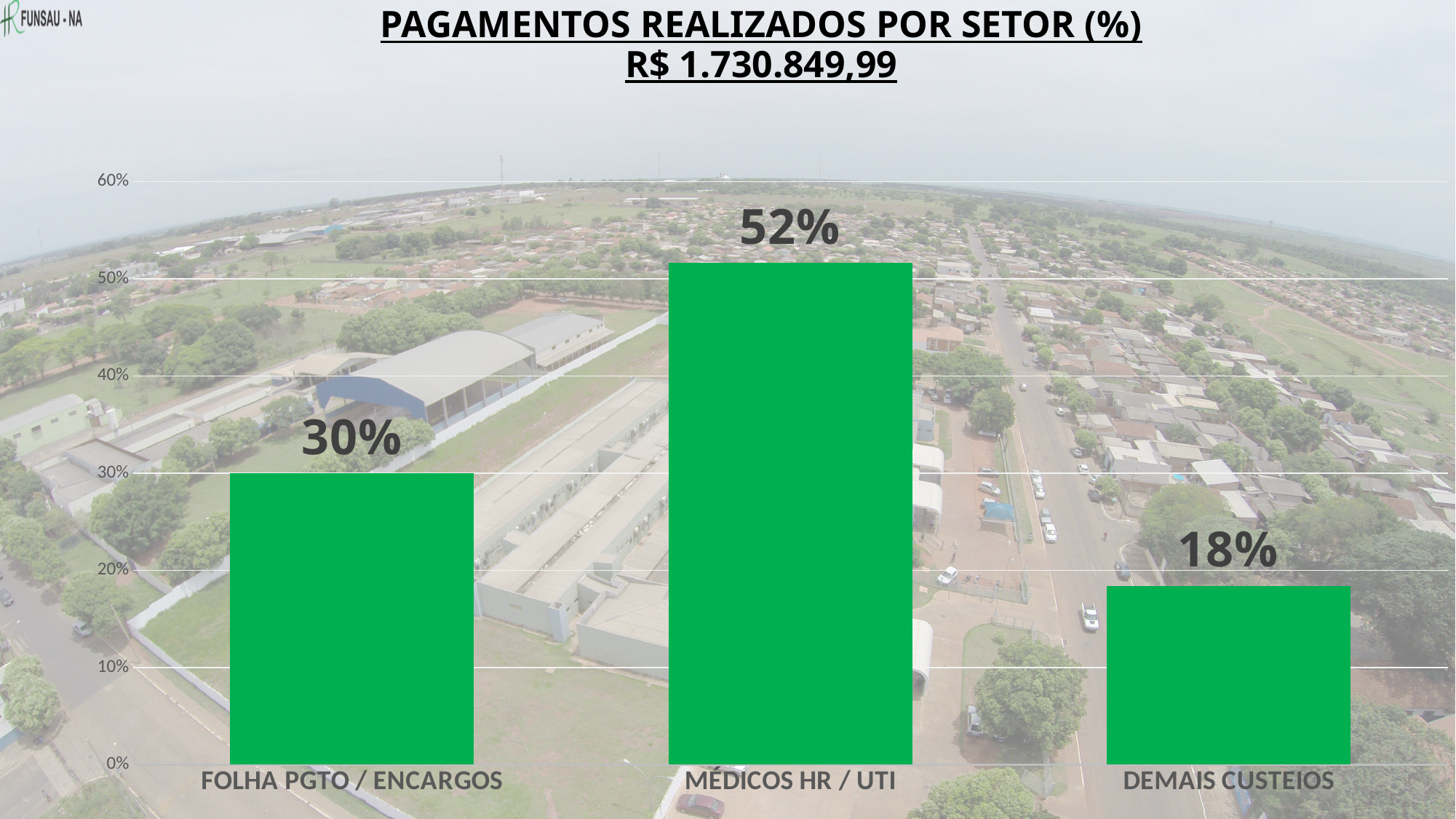
What is the value for FOLHA PGTO / ENCARGOS? 30% Which is larger, the value for FOLHA PGTO / ENCARGOS or the value for DEMAIS CUSTEIOS? FOLHA PGTO / ENCARGOS How many categories are shown in the chart? 3 Which category has the highest value? MÉDICOS HR / UTI What is the value for MÉDICOS HR / UTI? 52% Which category has the lowest value? DEMAIS CUSTEIOS What kind of chart is shown on the slide? bar chart What is the difference between the values for MÉDICOS HR / UTI and FOLHA PGTO / ENCARGOS? 22% What is the value for DEMAIS CUSTEIOS? 18% What is the title of the chart? PAGAMENTOS REALIZADOS POR SETOR (%) R$ 1.730.849,99 Is the value for MÉDICOS HR / UTI greater or less than 50%? greater What is the difference between the values for FOLHA PGTO / ENCARGOS and DEMAIS CUSTEIOS? 12%